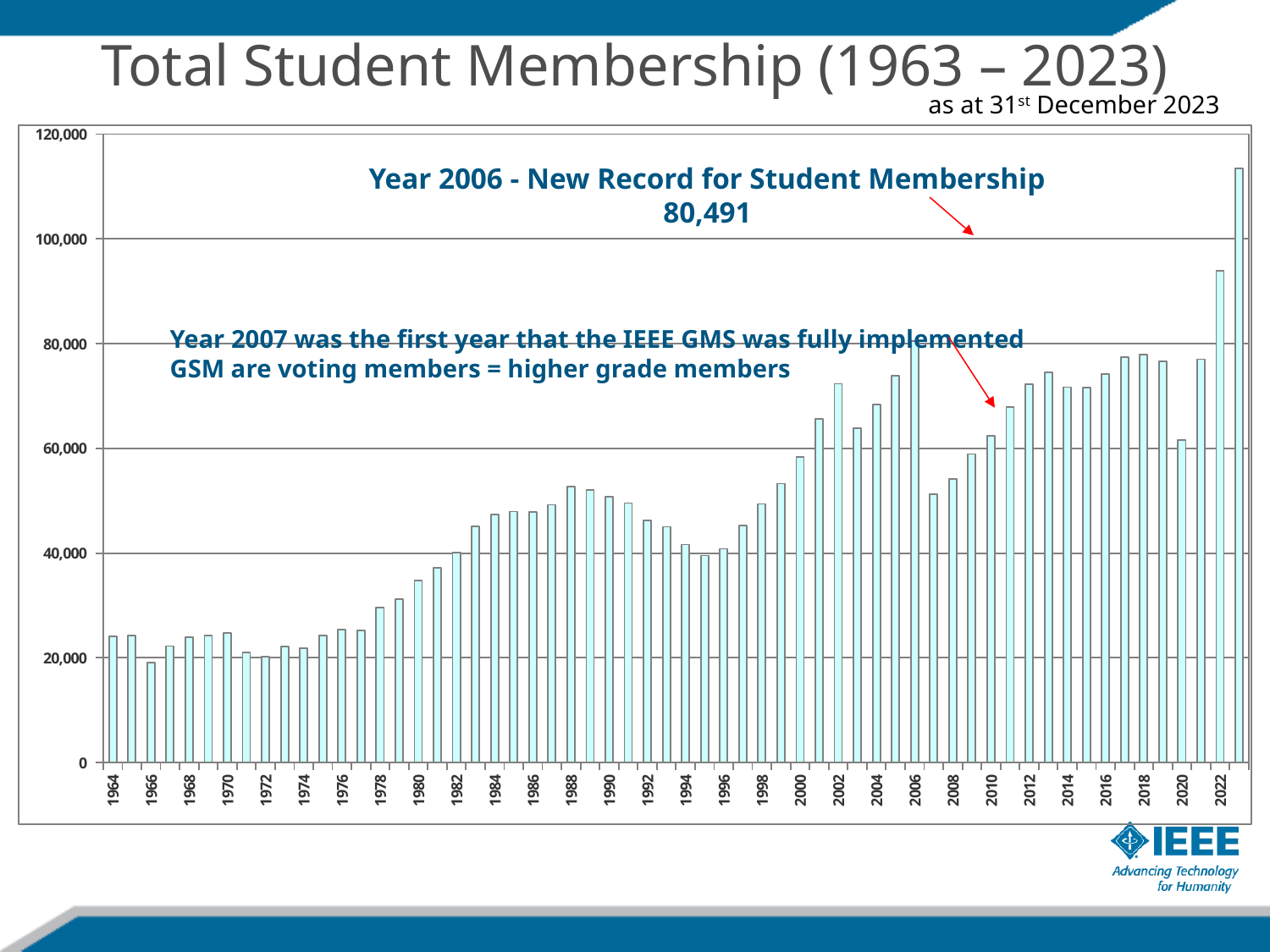
Is the value for 2022 greater or less than 80,000? greater What was the total student membership in 2006, according to the annotation on the chart? 80,491 What kind of chart is shown on the slide? bar chart Do the values generally rise or fall from 1988 to 1994? fall According to the subtitle, as at what date is the data shown? 31st December 2023 Is the value for 1988 greater or less than 40,000? greater Which year has the larger value, 2006 or 2008? 2006 Do the values generally rise or fall from 1976 to 1988? rise Which year is labelled on the chart as a new record for student membership? 2006 Is the value for 1978 greater or less than 40,000? less Which year has the larger value, 1964 or 1980? 1980